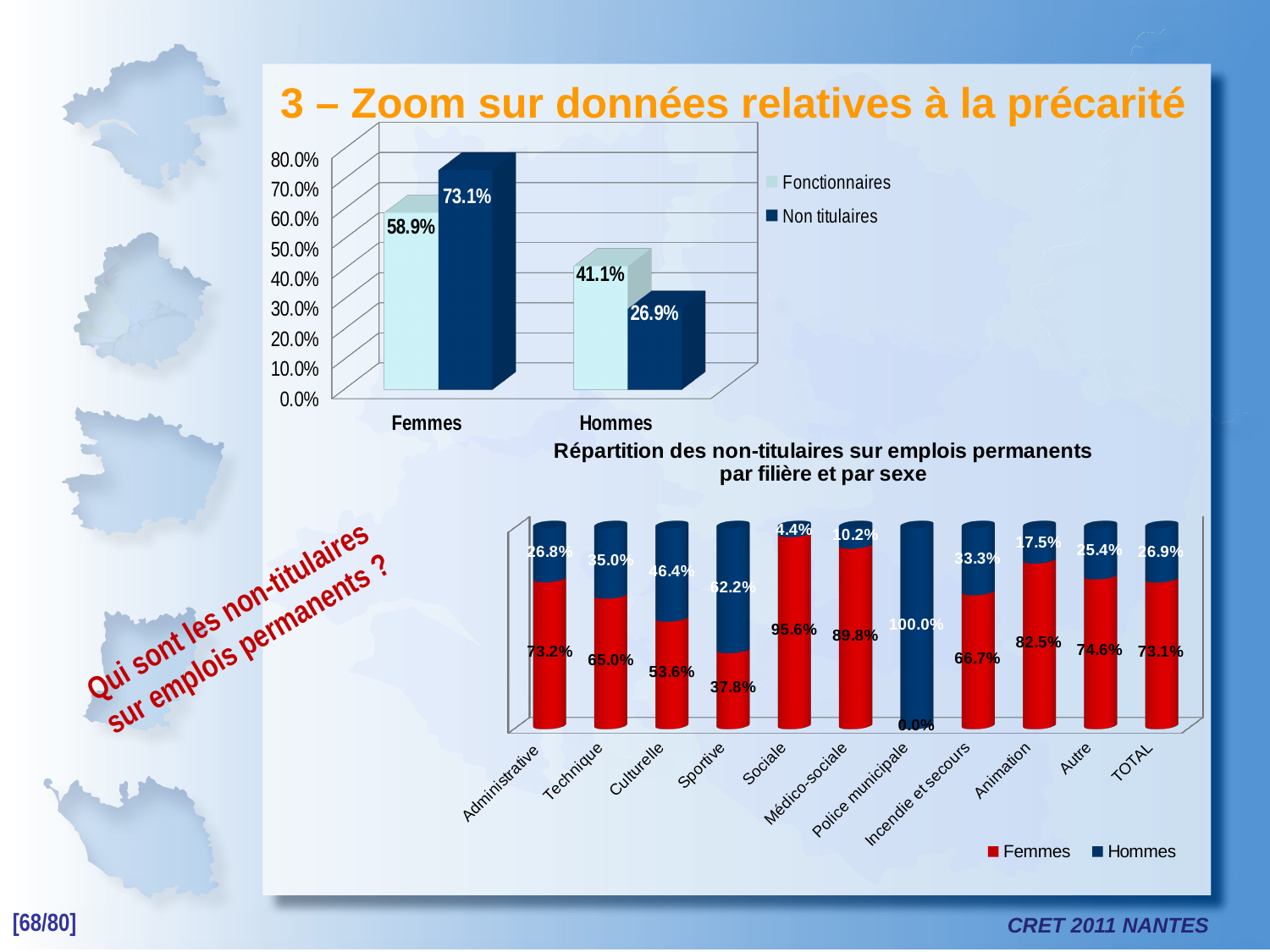
In the top chart, what is the value for Non titulaires among Femmes? 73.1% In the chart titled 'Répartition des non-titulaires sur emplois permanents par filière et par sexe', what is the total of the stacked bar for Technique? 100.0% In the top chart, how many series does the legend list? 2 In the chart titled 'Répartition des non-titulaires sur emplois permanents par filière et par sexe', what is the Hommes value for Incendie et secours? 33.3% In the chart titled 'Répartition des non-titulaires sur emplois permanents par filière et par sexe', which category has the lowest Femmes value? Police municipale In the top chart, which is larger for Hommes: Fonctionnaires or Non titulaires? Fonctionnaires What kind of chart is the chart titled 'Répartition des non-titulaires sur emplois permanents par filière et par sexe'? Stacked bar chart In the chart titled 'Répartition des non-titulaires sur emplois permanents par filière et par sexe', how many categories are shown on the x axis? 11 In the top chart, what is the difference between the Fonctionnaires values for Femmes and Hommes? 17.8% In the top chart, what is the value for Fonctionnaires among Hommes? 41.1% In the chart titled 'Répartition des non-titulaires sur emplois permanents par filière et par sexe', which category has the highest Femmes value? Sociale In the chart titled 'Répartition des non-titulaires sur emplois permanents par filière et par sexe', what is the Femmes value for Sportive? 37.8%